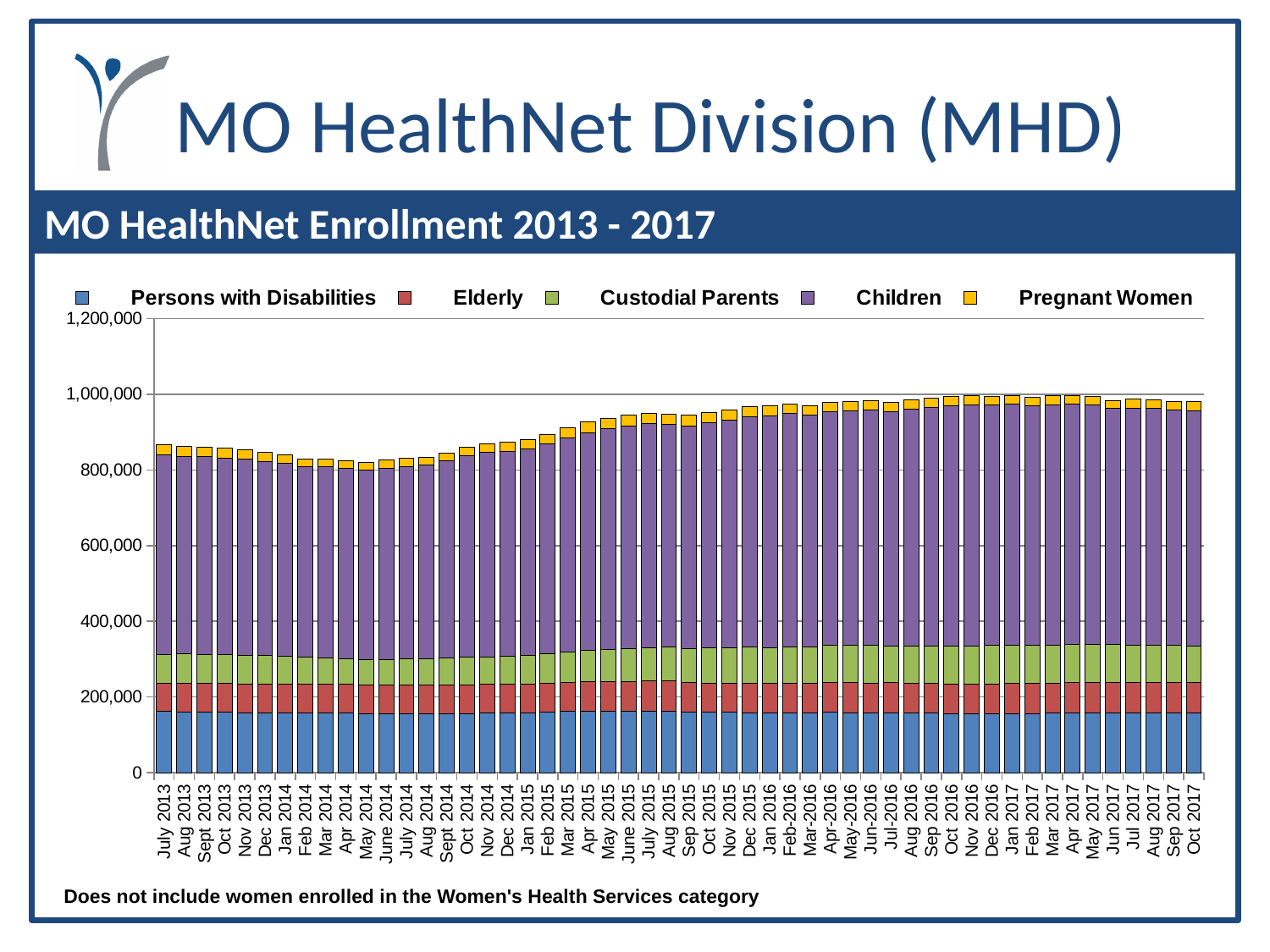
How many monthly bars are plotted in the chart? 52 Does total enrollment rise or fall overall from July 2013 to Oct 2017? Rises Does total enrollment rise or fall from July 2013 to May 2014? Falls What is the title of the chart? MO HealthNet Enrollment 2013 - 2017 Is the total enrollment for July 2015 greater or less than 1,000,000? less How many series does the legend list? 5 Is the Persons with Disabilities value for July 2013 greater or less than 200,000? less What kind of chart is shown on the slide? Stacked bar chart Which enrollment category makes up the largest segment of each bar? Children Which month has the larger total enrollment, May 2014 or Dec 2016? Dec 2016 Which enrollment category makes up the smallest segment of each bar? Pregnant Women Is the total enrollment for July 2013 greater or less than 800,000? greater